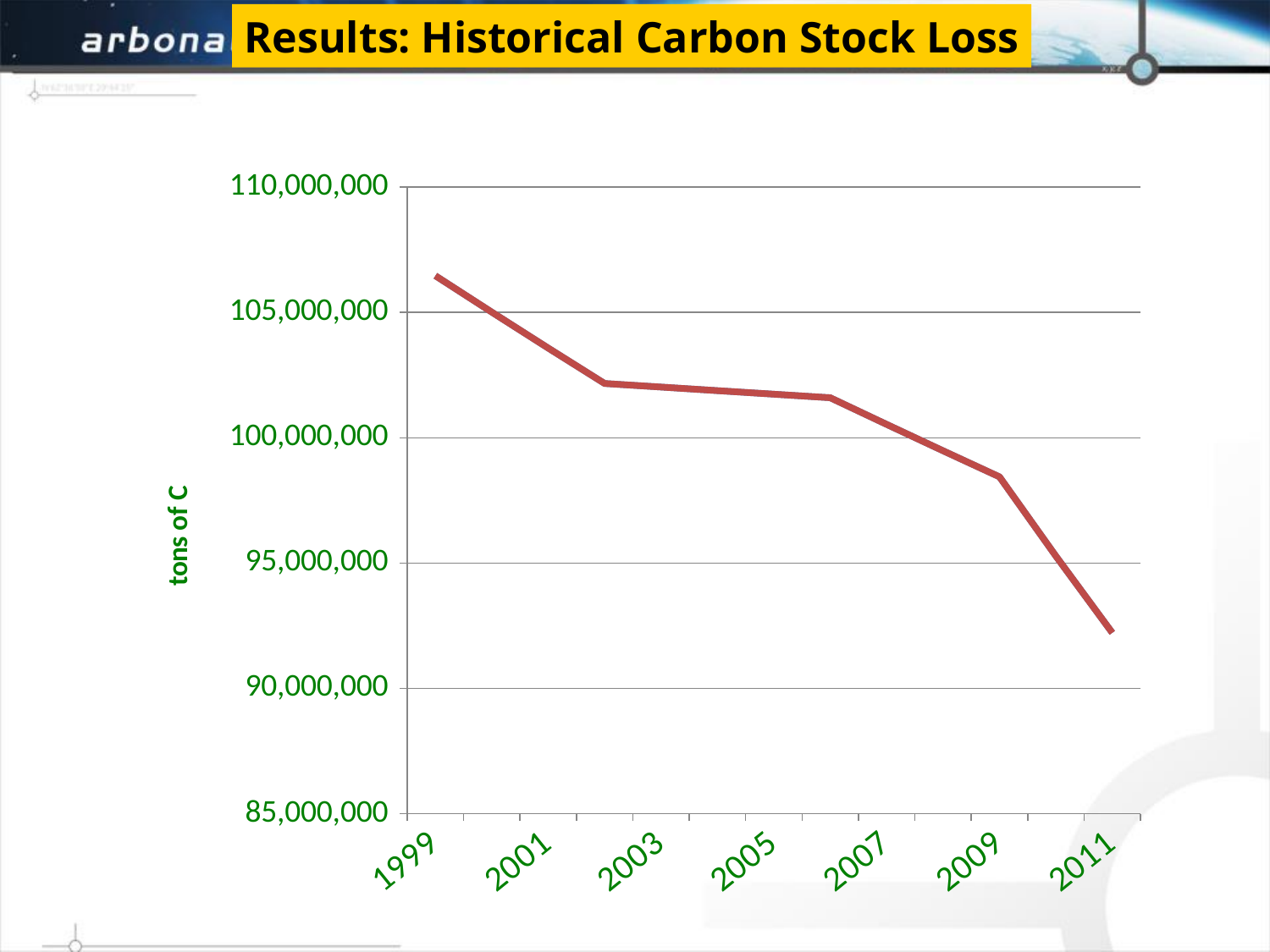
Is the value for 2011 greater or less than 90,000,000? greater What is the label on the vertical axis of the chart? tons of C Is the value for 2011 greater or less than 95,000,000? less What is the title of the slide containing the chart? Results: Historical Carbon Stock Loss Do the values rise or fall from 1999 to 2011? fall What is the highest value shown on the vertical axis? 110,000,000 Which is larger, the value for 1999 or the value for 2011? 1999 In which year is the carbon stock lowest? 2011 Is the value for 1999 greater or less than 105,000,000? greater In which year is the carbon stock highest? 1999 What kind of chart is shown on the slide? line chart How many year labels are shown on the horizontal axis? 7